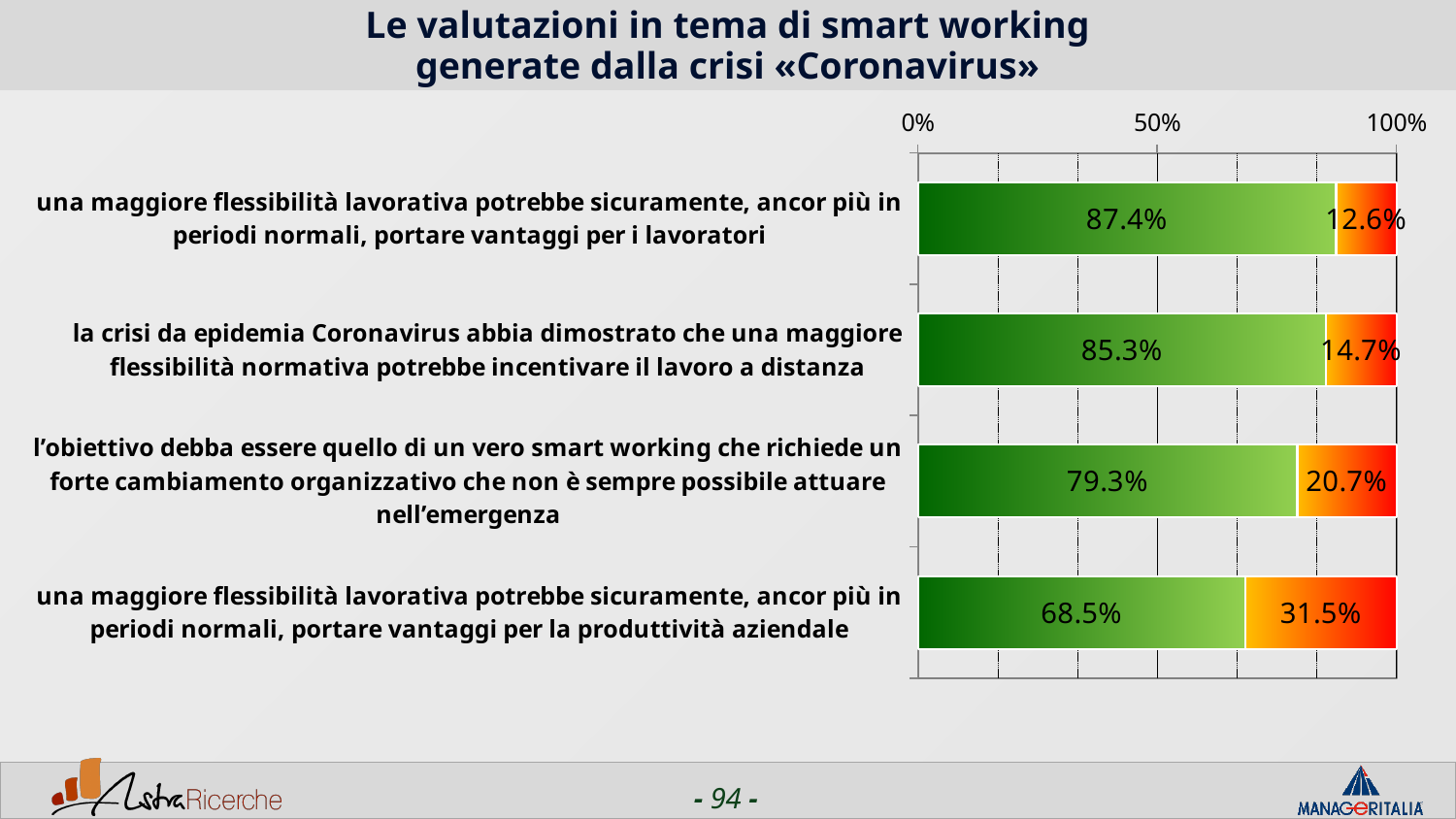
Which is larger: the orange segment for the 'lavoro a distanza' statement or the orange segment for the 'vero smart working' statement? the 'vero smart working' statement (20.7%) What is the difference between the green segment for the 'vantaggi per i lavoratori' statement and the green segment for the 'vantaggi per la produttività aziendale' statement? 18.9% What is the title of the slide? Le valutazioni in tema di smart working generate dalla crisi «Coronavirus» Which statement has the largest green segment? una maggiore flessibilità lavorativa potrebbe sicuramente, ancor più in periodi normali, portare vantaggi per i lavoratori What kind of chart is shown on the slide? stacked horizontal bar chart What is the total of the two segments in the bar for the 'vero smart working' statement? 100% What is the orange segment value for the statement about a true smart working requiring a strong organizational change? 20.7% What is the green segment value for the statement that the Coronavirus crisis showed that greater regulatory flexibility could encourage remote work? 85.3% Which statement has the smallest green segment? una maggiore flessibilità lavorativa potrebbe sicuramente, ancor più in periodi normali, portare vantaggi per la produttività aziendale What is the green segment value for the statement about flexibility bringing advantages 'per i lavoratori'? 87.4% How many statements (bars) are shown in the chart? 4 What is the orange segment value for the statement about flexibility bringing advantages 'per la produttività aziendale'? 31.5%